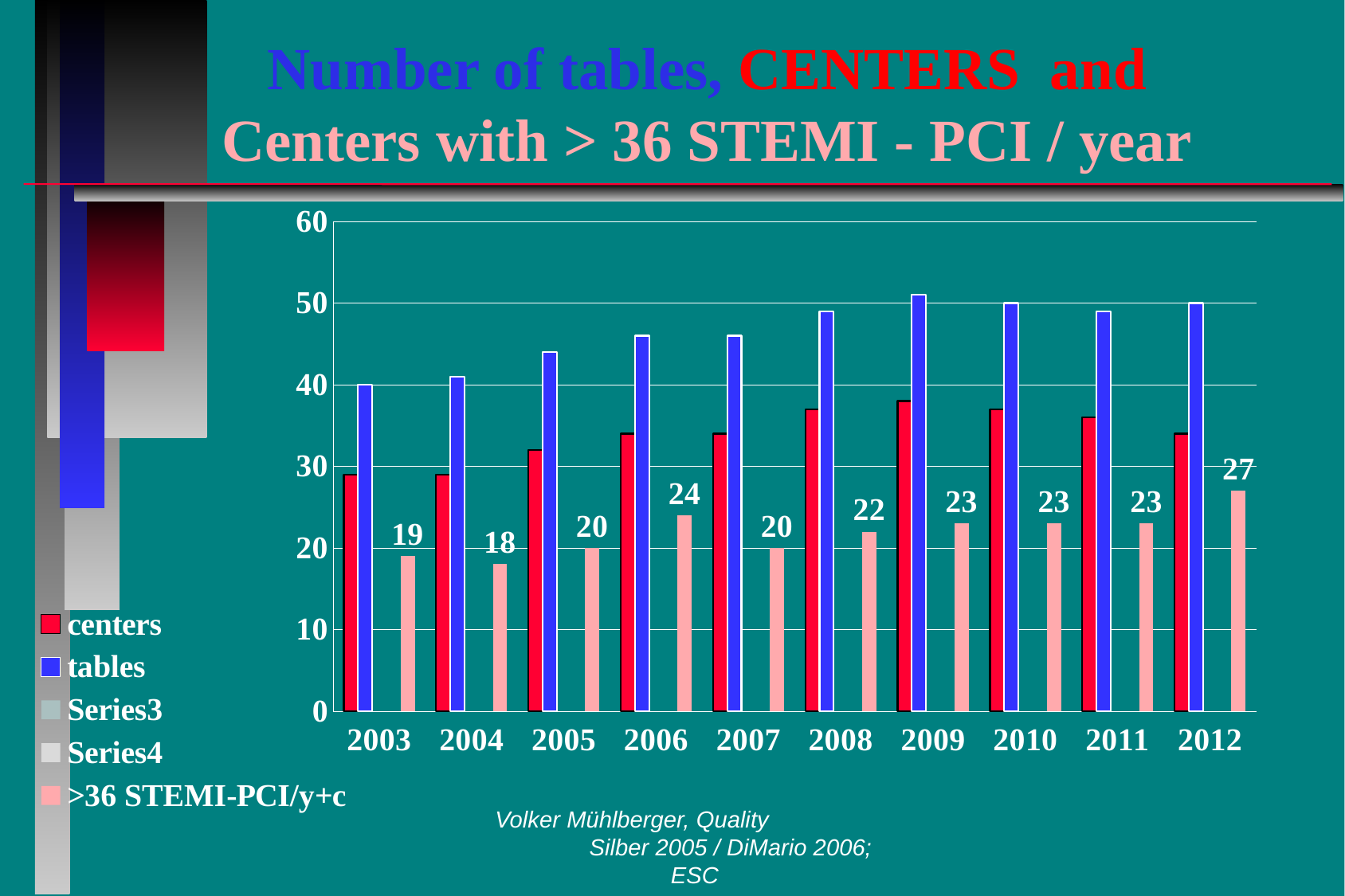
What is the value of the >36 STEMI-PCI/y+c series for 2012? 27 Is the value for tables in 2009 greater or less than 50? greater What is the value of the >36 STEMI-PCI/y+c series for 2006? 24 Is the value for centers in 2003 greater or less than 30? less What is the difference between the >36 STEMI-PCI/y+c values for 2012 and 2004? 9 How many series does the legend list? 5 Which year has the larger >36 STEMI-PCI/y+c value, 2006 or 2007? 2006 In which year is the >36 STEMI-PCI/y+c value highest? 2012 What kind of chart is shown on the slide? bar chart How many years are shown on the x axis of the chart? 10 In which year is the >36 STEMI-PCI/y+c value lowest? 2004 Is the value for centers in 2009 greater or less than 30? greater